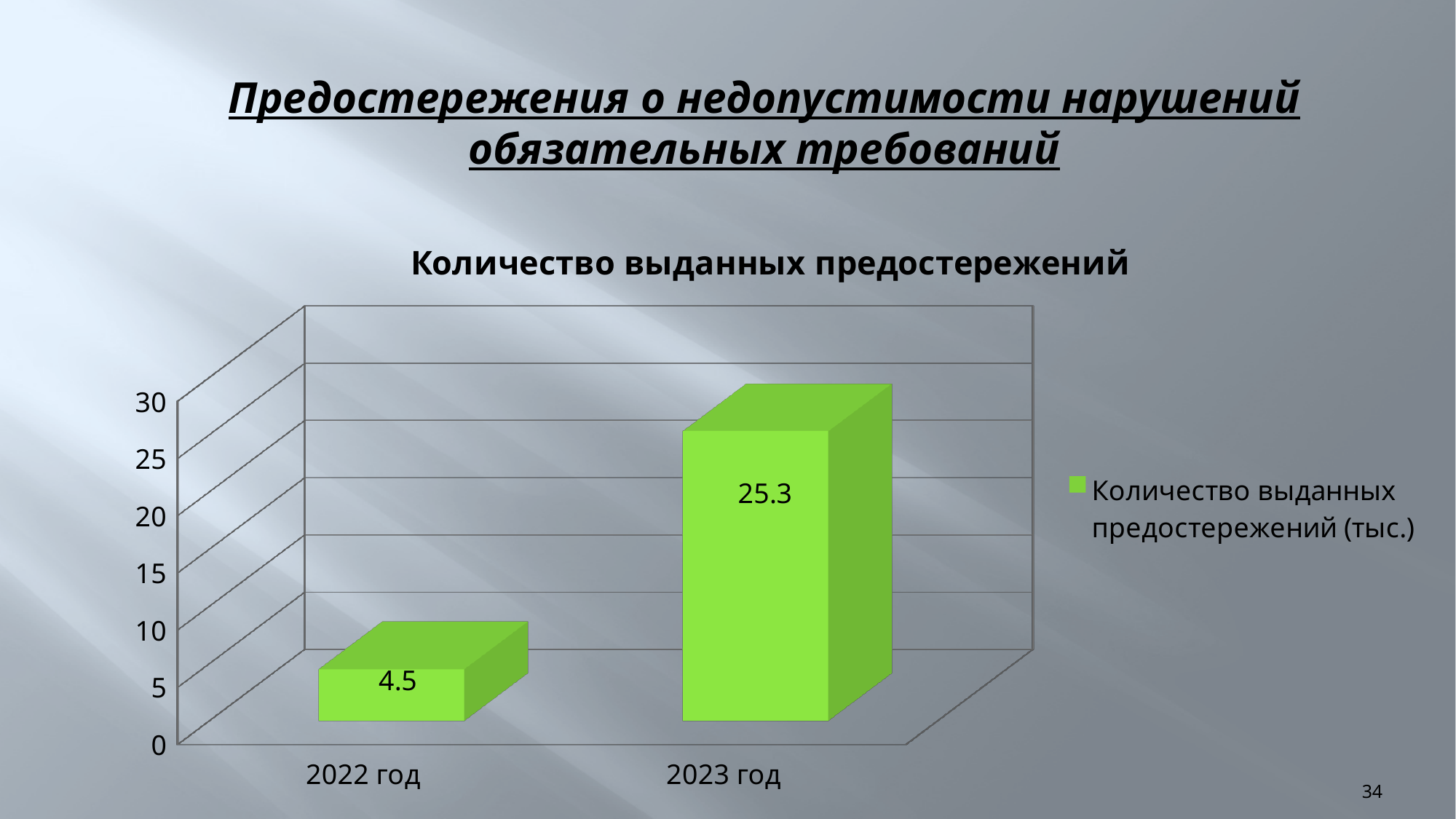
Which is larger, the value for 2022 год or 2023 год? 2023 год Which year has the lowest value? 2022 год How many series does the legend list? 1 Is the value for 2023 год greater or less than 20? greater What is the value for 2023 год? 25.3 How many categories are shown on the x axis? 2 Which year has the highest value? 2023 год What is the title of the chart? Количество выданных предостережений What is the value for 2022 год? 4.5 What kind of chart is shown? bar chart Is the value for 2022 год greater or less than 10? less What is the difference between the values for 2023 год and 2022 год? 20.8